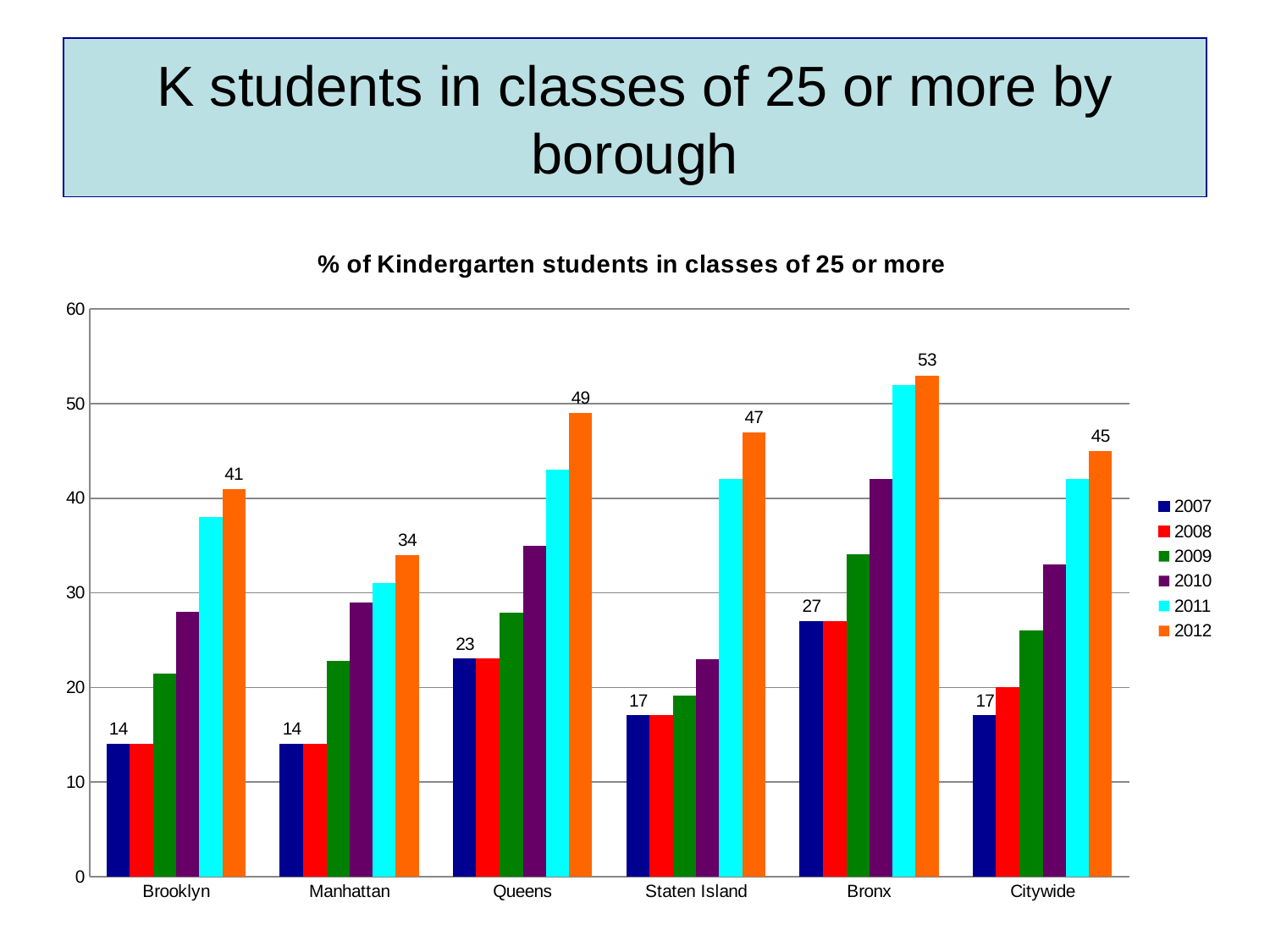
What is the value for the Bronx in 2012? 53 Which category has the lowest value for 2012? Manhattan How many categories are shown on the x axis? 6 What is the difference between the 2012 and 2007 values for Brooklyn? 27 Is the value for the Bronx in 2011 greater or less than 50? greater Which category has the highest value for 2012? Bronx Do the values for Citywide rise or fall from 2007 to 2012? rise How many series does the legend list? 6 Which is larger, the 2012 value for Queens or the 2012 value for Staten Island? Queens Is the value for Manhattan in 2010 greater or less than 30? less What kind of chart is shown on the slide? bar chart What is the value for Queens in 2007? 23